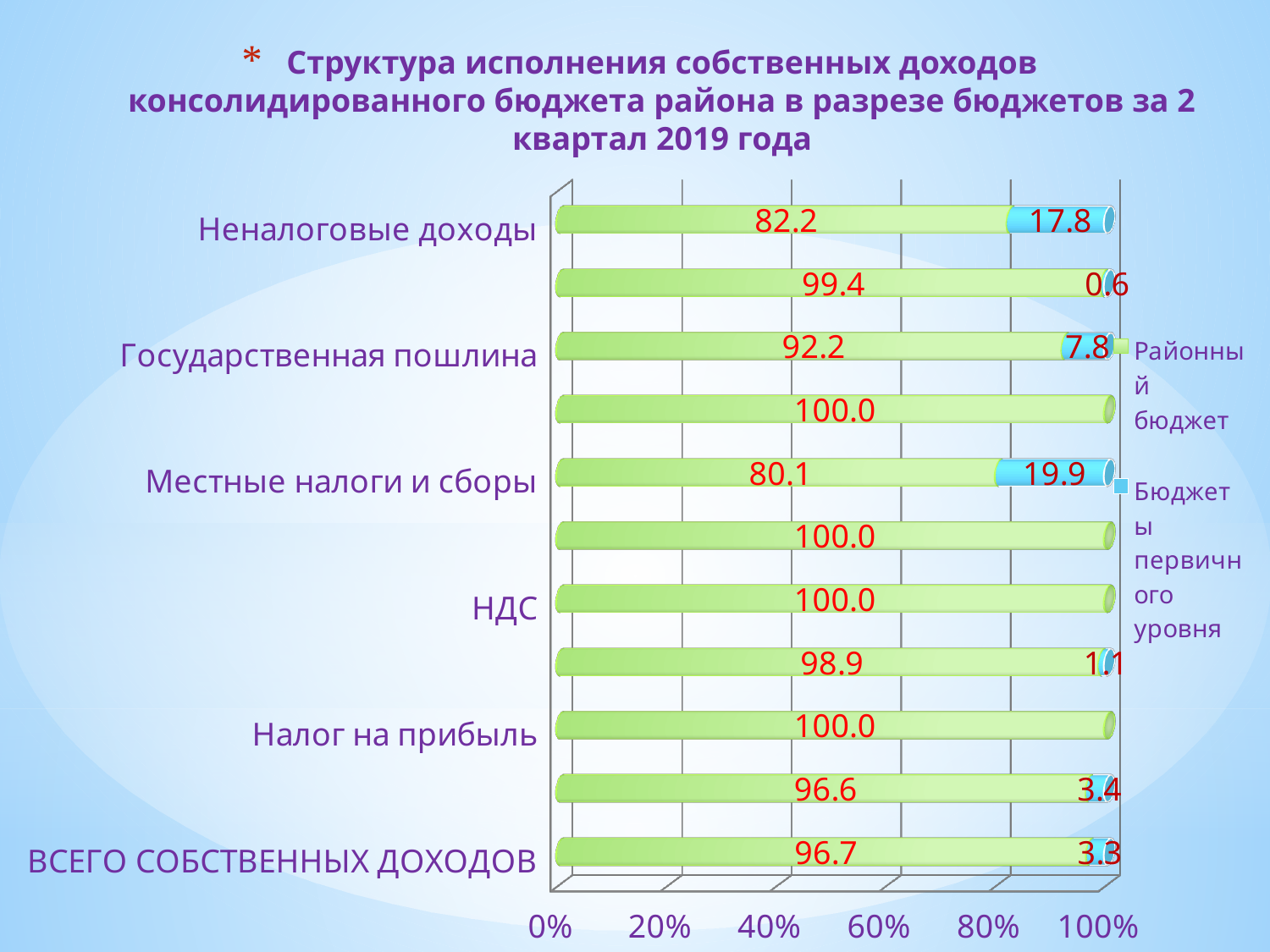
What is the value of Бюджеты первичного уровня for Местные налоги и сборы? 19.9 What is the value of Районный бюджет for ВСЕГО СОБСТВЕННЫХ ДОХОДОВ? 96.7 What is the value of Бюджеты первичного уровня for Неналоговые доходы? 17.8 What is the value of Районный бюджет for НДС? 100.0 What type of chart is shown on the slide? Stacked bar chart Among the labeled categories, which has the lowest Районный бюджет value? Местные налоги и сборы Which is larger: the Бюджеты первичного уровня value for Местные налоги и сборы or for Государственная пошлина? Местные налоги и сборы What is the value of Районный бюджет for Государственная пошлина? 92.2 What is the difference between the Районный бюджет values for Государственная пошлина and Неналоговые доходы? 10.0 Which series is shown in green in the legend? Районный бюджет How many series does the legend list? 2 What is the value of Районный бюджет for Неналоговые доходы? 82.2